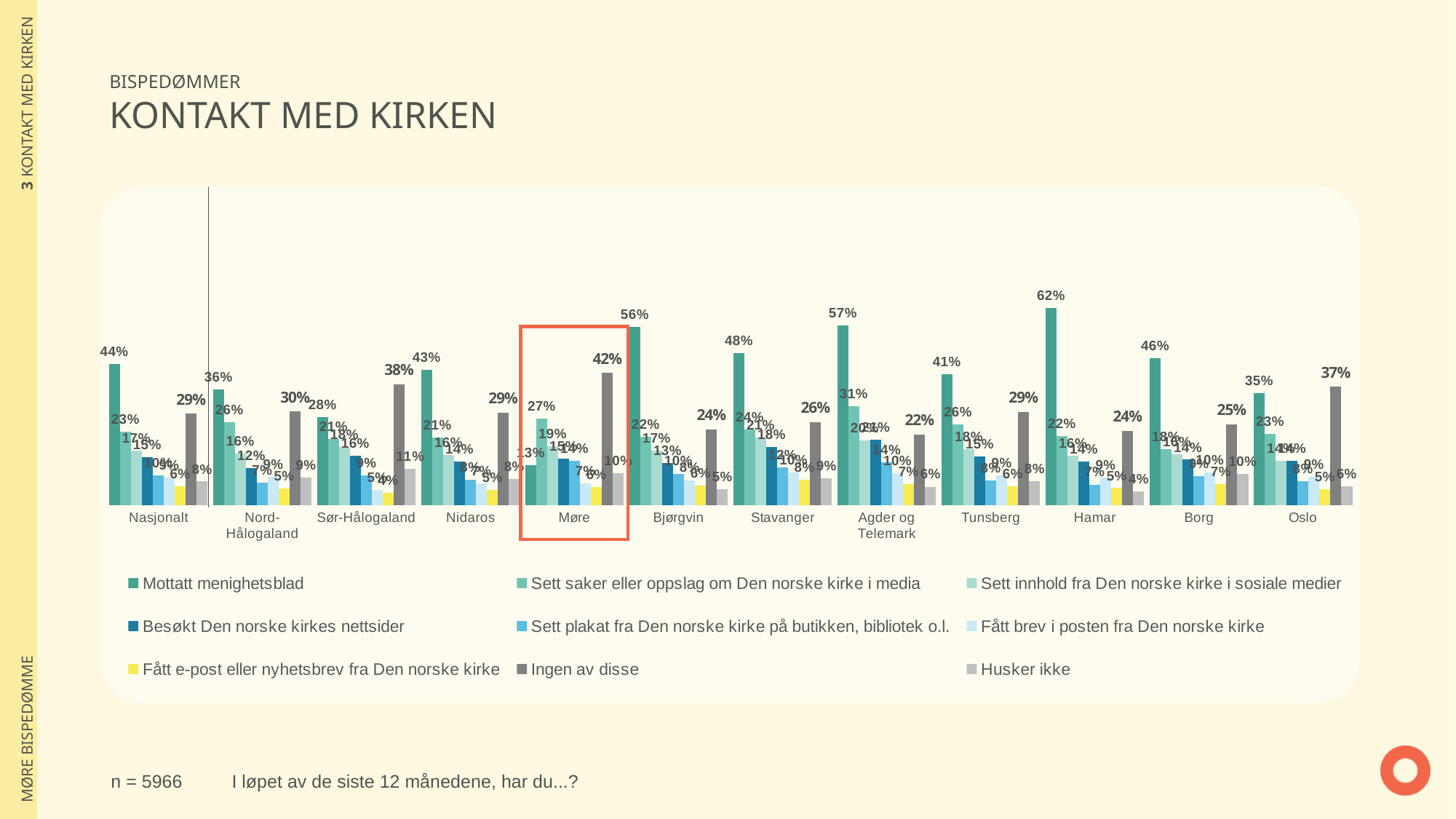
How many series does the legend list? 9 How many categories (bispedømmer including Nasjonalt) are shown along the x axis? 12 What type of chart is shown on the slide? bar chart What is the value for 'Mottatt menighetsblad' for Nasjonalt? 44% Which category has the highest value for 'Ingen av disse'? Møre Which category has the highest value for 'Mottatt menighetsblad'? Hamar What is the value for 'Mottatt menighetsblad' in Hamar? 62% Which is larger: 'Mottatt menighetsblad' in Bjørgvin or in Stavanger? Bjørgvin What is the difference between the 'Mottatt menighetsblad' values for Hamar and Møre? 49 percentage points Which category is highlighted with an orange box on the chart? Møre Which category has the lowest value for 'Mottatt menighetsblad'? Møre What is the value for 'Ingen av disse' in Møre? 42%